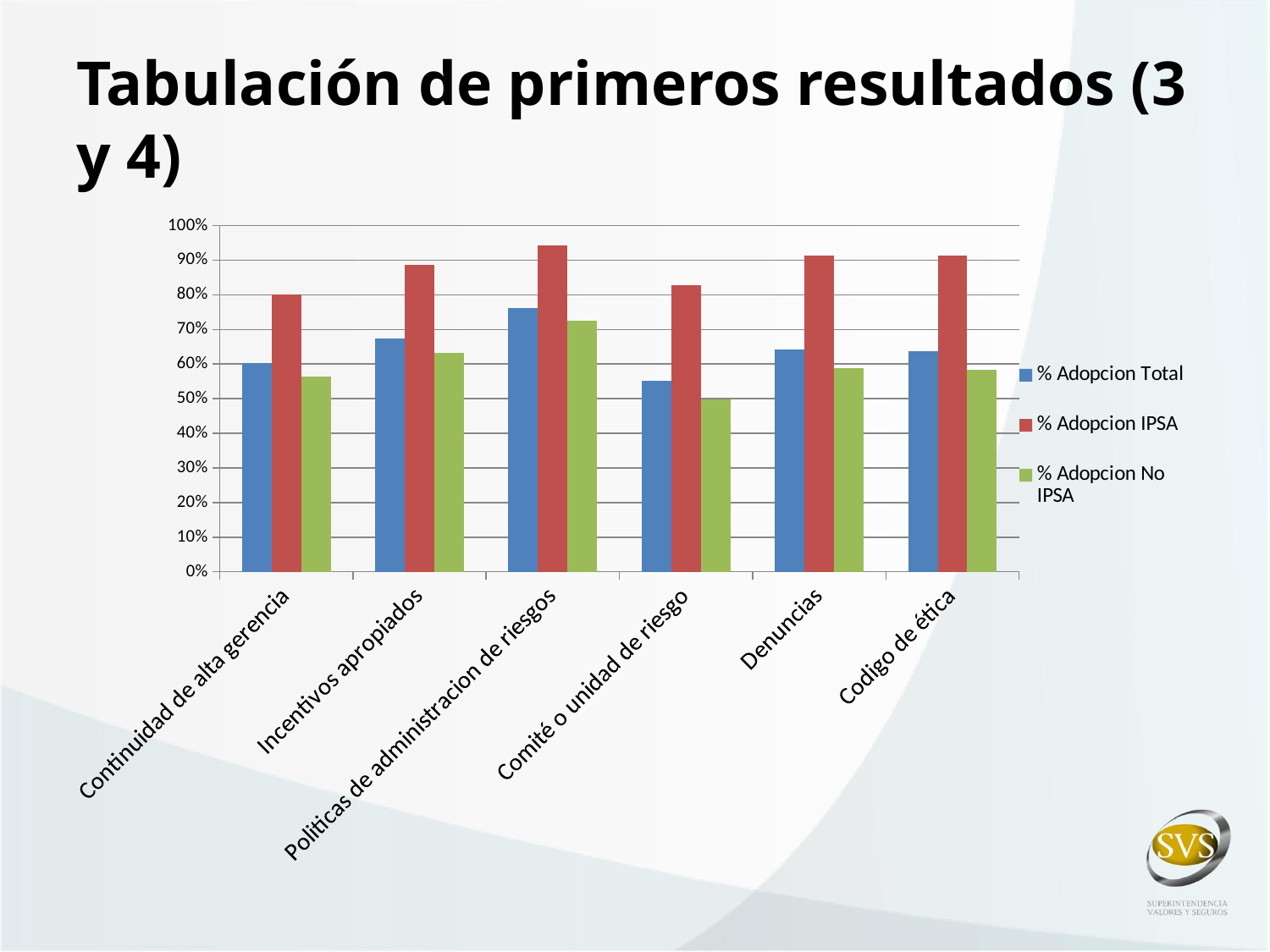
Is the % Adopcion Total value for Politicas de administracion de riesgos greater or less than 70%? greater Which category has the highest value for % Adopcion Total? Politicas de administracion de riesgos What kind of chart is shown on the slide? bar chart Which category has the lowest value for % Adopcion Total? Comité o unidad de riesgo Which category has the highest value for % Adopcion IPSA? Politicas de administracion de riesgos Which category has the lowest value for % Adopcion No IPSA? Comité o unidad de riesgo Is the % Adopcion Total value for Comité o unidad de riesgo greater or less than 60%? less Which is larger: the % Adopcion IPSA value for Incentivos apropiados or for Comité o unidad de riesgo? Incentivos apropiados How many series does the chart's legend list? 3 Is the % Adopcion IPSA value for Politicas de administracion de riesgos greater or less than 90%? greater How many categories are shown on the x axis of the chart? 6 Which series is shown in red in the chart? % Adopcion IPSA